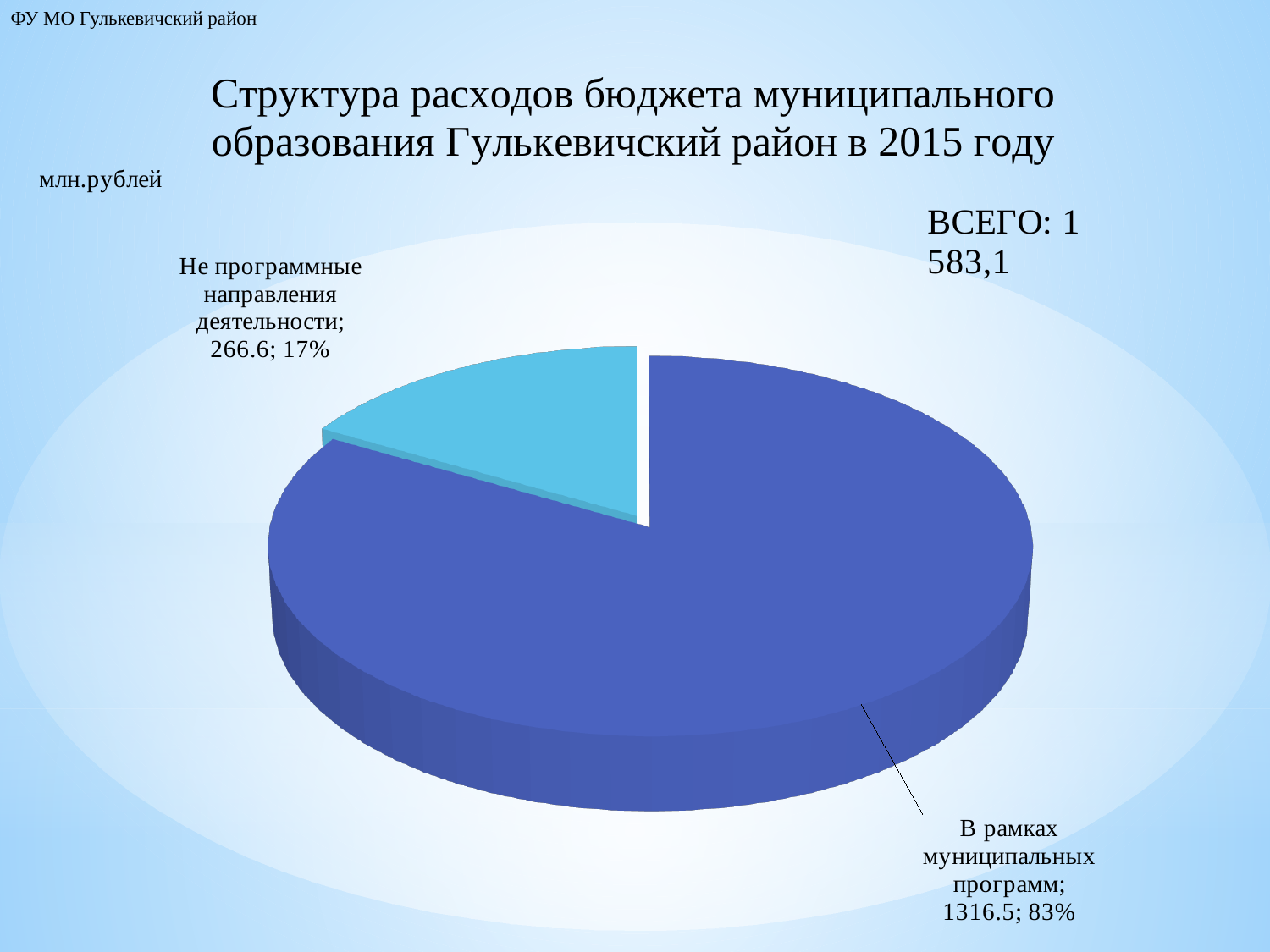
Which is larger: "В рамках муниципальных программ" or "Не программные направления деятельности"? В рамках муниципальных программ Which slice is the smallest? Не программные направления деятельности What share of the pie does "Не программные направления деятельности" represent? 17% What is the value for "В рамках муниципальных программ"? 1316.5 What is the difference between the values for "В рамках муниципальных программ" and "Не программные направления деятельности"? 1049.9 Which slice is the largest? В рамках муниципальных программ What total (ВСЕГО) is stated on the slide? 1 583,1 How many slices does the pie chart have? 2 What unit of measurement is indicated on the slide? млн.рублей What kind of chart is shown on the slide? pie chart What is the value for "Не программные направления деятельности"? 266.6 What share of the pie does "В рамках муниципальных программ" represent? 83%